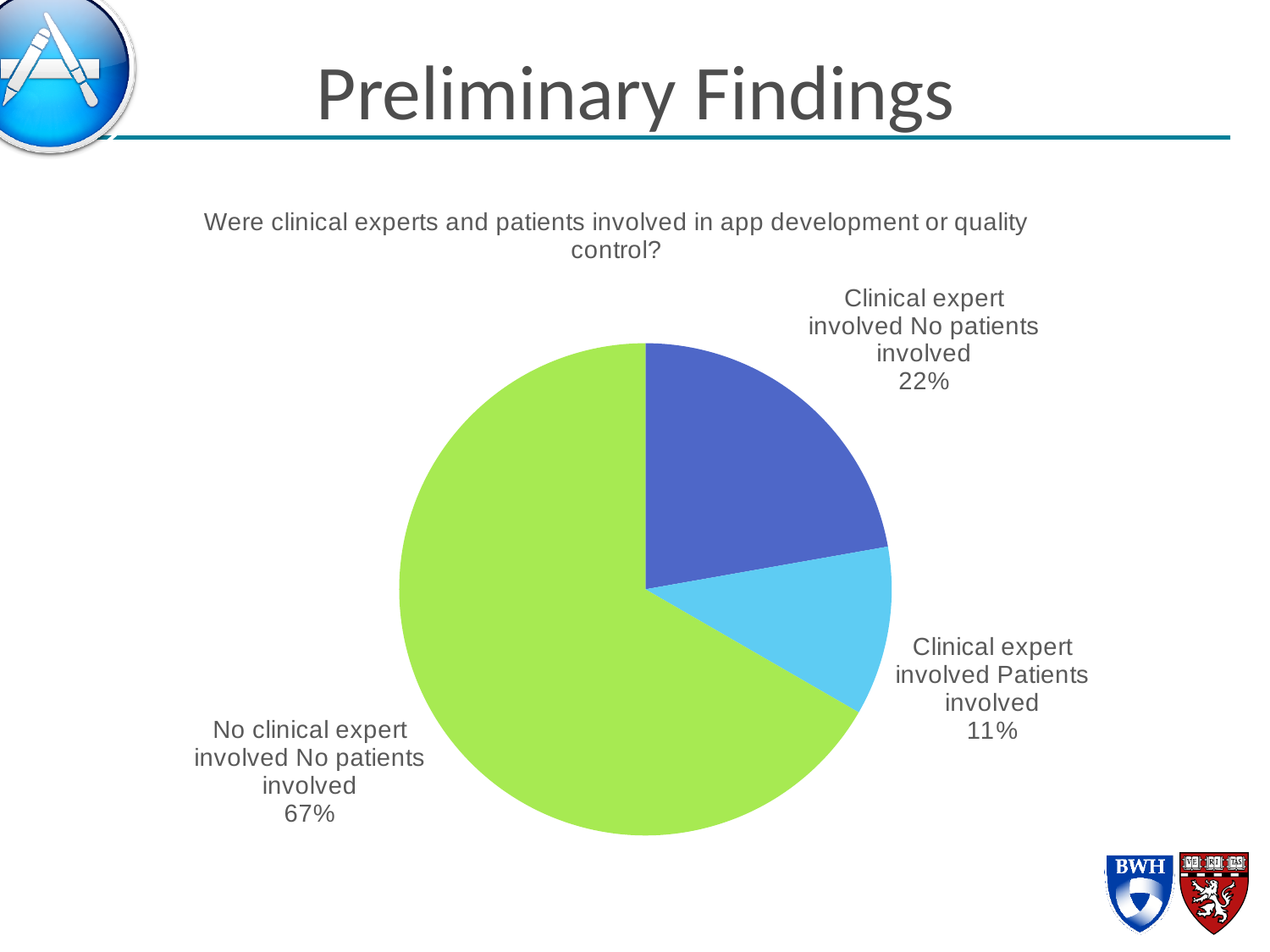
Which is larger: the share for 'Clinical expert involved No patients involved' or 'Clinical expert involved Patients involved'? Clinical expert involved No patients involved What share of the pie is 'Clinical expert involved No patients involved'? 22% What colour is the slice for 'No clinical expert involved No patients involved'? green What kind of chart is shown on the slide? pie chart What is the title of the chart? Were clinical experts and patients involved in app development or quality control? Which category has the largest slice of the pie? No clinical expert involved No patients involved What share of the pie is 'No clinical expert involved No patients involved'? 67% What is the difference in percentage points between 'No clinical expert involved No patients involved' and 'Clinical expert involved No patients involved'? 45 What share of the pie is 'Clinical expert involved Patients involved'? 11% What is the difference in percentage points between 'Clinical expert involved No patients involved' and 'Clinical expert involved Patients involved'? 11 How many slices does the pie chart have? 3 Which category has the smallest slice of the pie? Clinical expert involved Patients involved